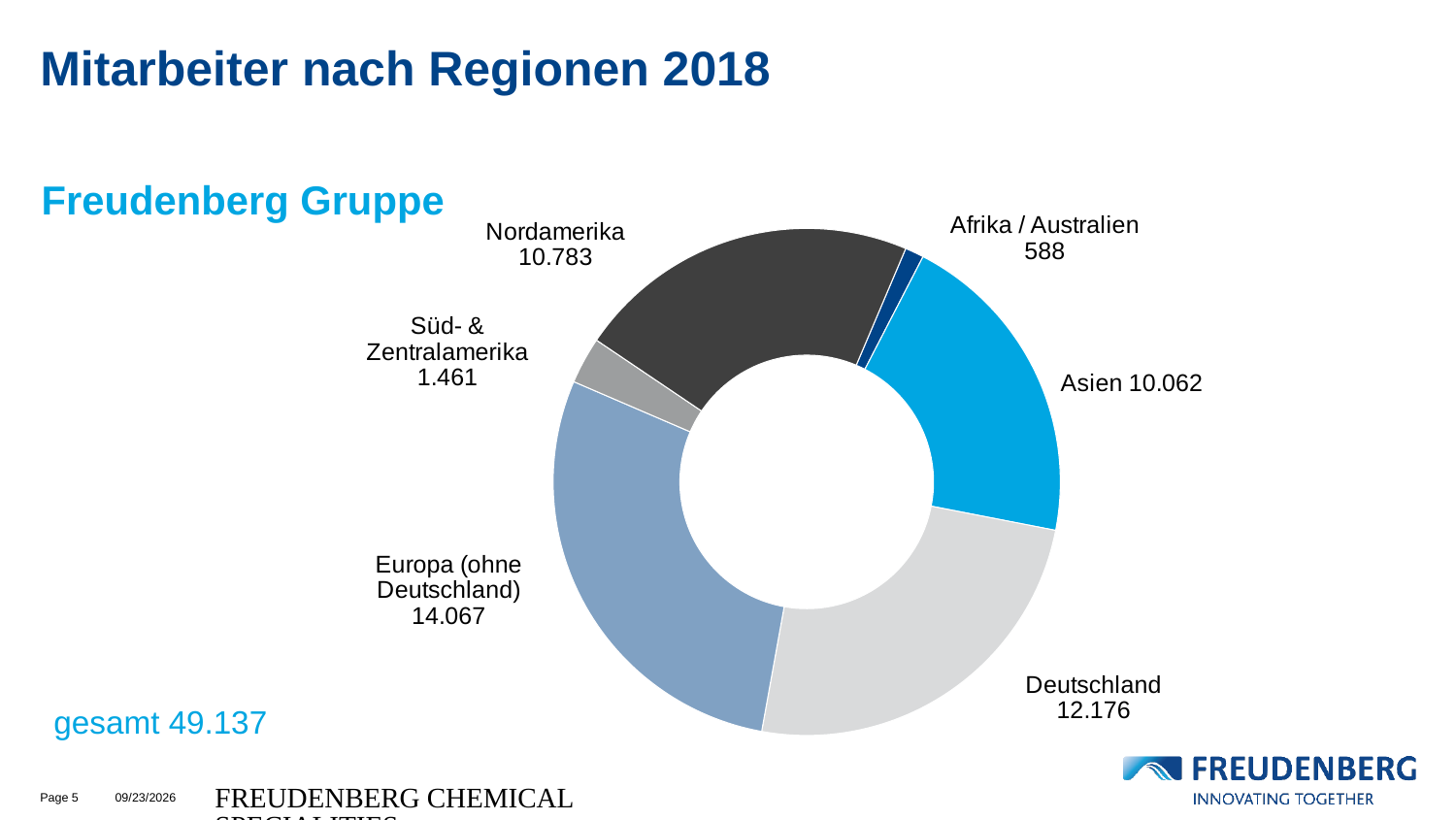
What is the difference between Nordamerika and Asien? 721 What total number of employees is stated on the slide? 49.137 Which is larger, Deutschland or Nordamerika? Deutschland What value is shown for Europa (ohne Deutschland)? 14.067 What is the difference between Europa (ohne Deutschland) and Deutschland? 1.891 How many employees does the chart show for Nordamerika? 10.783 How many regions are shown in the chart? 6 What is the value shown for Asien? 10.062 Which region has the smallest number of employees? Afrika / Australien What kind of chart is shown on the slide? doughnut chart What is the value for Afrika / Australien? 588 Which region has the largest number of employees? Europa (ohne Deutschland)